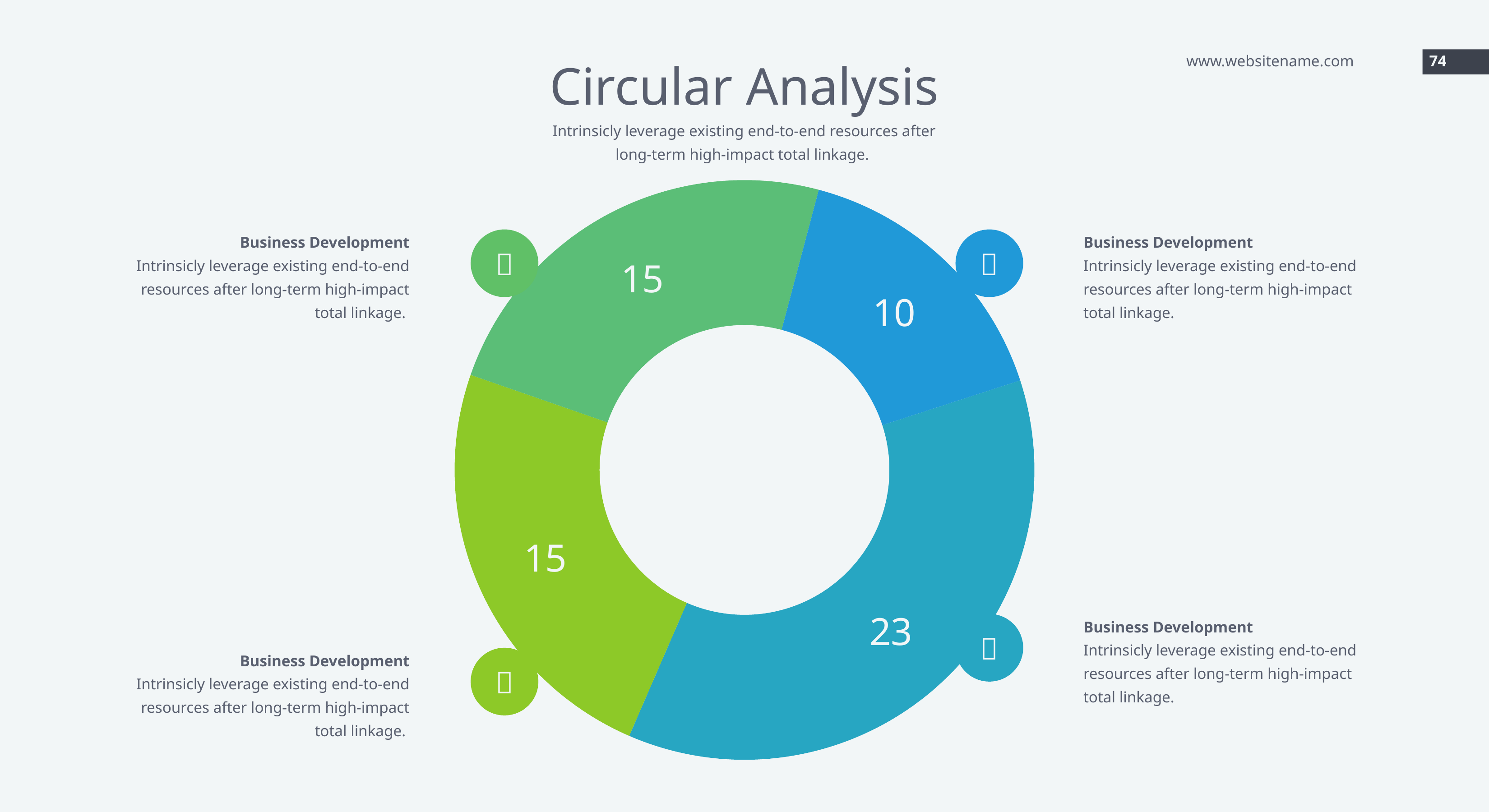
What is the value of the green segment at the top left of the donut chart? 15 What is the title of the slide containing the donut chart? Circular Analysis Which segment of the donut chart has the smallest value? The dark blue top-right segment (10) What is the value of the teal segment at the bottom right of the donut chart? 23 What is the value of the dark blue segment at the top right of the donut chart? 10 Which segment of the donut chart has the largest value? The teal bottom-right segment (23) What kind of chart is shown on the slide? Donut (pie) chart Which is larger: the teal bottom-right segment or the green top-left segment? The teal bottom-right segment (23) What is the value of the lime green segment at the bottom left of the donut chart? 15 What is the sum of all four segment values in the donut chart? 63 What is the difference between the largest segment value (23) and the smallest segment value (10)? 13 How many segments does the donut chart have? 4